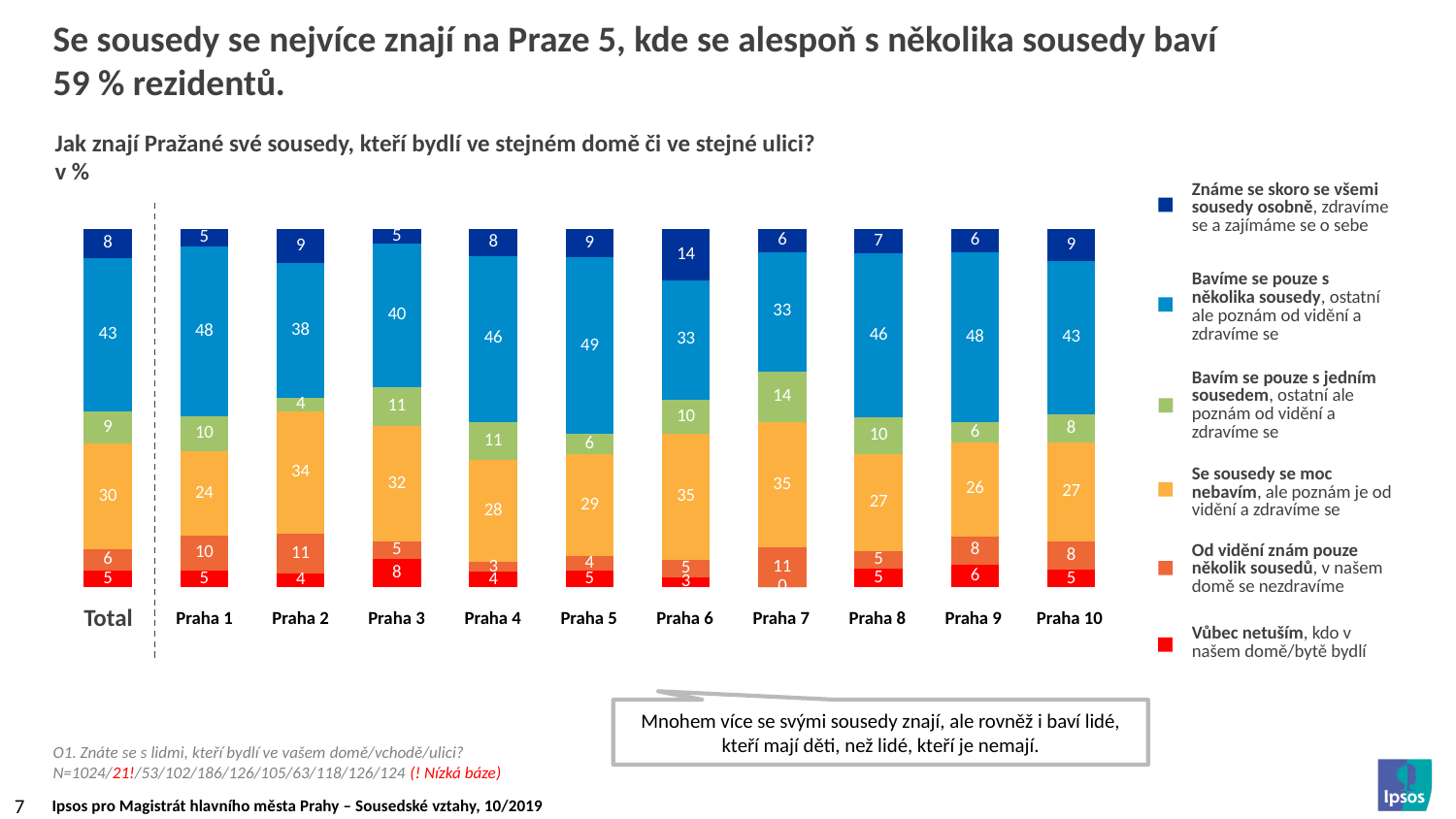
Which is larger: the 'Se sousedy se moc nebavím' value for Praha 1 or for Praha 3? Praha 3 What kind of chart is shown on the slide? Stacked bar chart How many categories are shown on the x axis? 11 What is the value for 'Známe se skoro se všemi sousedy osobně' for Total? 8 What is the value for 'Bavím se pouze s jedním sousedem' for Praha 7? 14 What is the value for 'Bavíme se pouze s několika sousedy' for Praha 5? 49 How many series does the legend list? 6 What is the value for 'Se sousedy se moc nebavím' for Praha 2? 34 What is the difference between the 'Bavíme se pouze s několika sousedy' values for Praha 5 and Praha 6? 16 Which colour represents 'Vůbec netuším' in the legend? Red Which category has the lowest value for 'Vůbec netuším'? Praha 7 Which category has the highest value for 'Známe se skoro se všemi sousedy osobně'? Praha 6